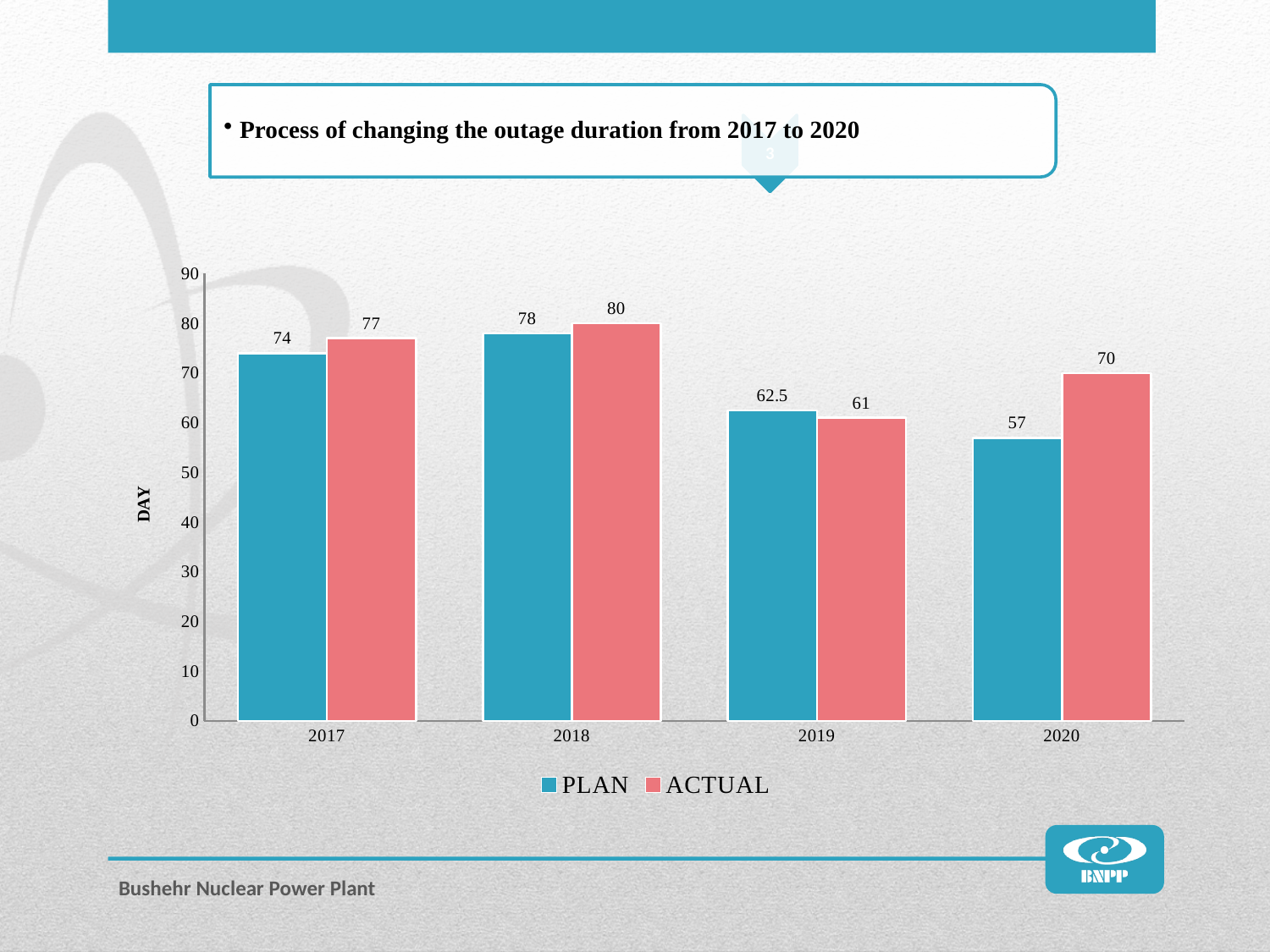
What is the label on the vertical axis? DAY What is the PLAN value for 2017? 74 What is the difference between the PLAN values for 2018 and 2019? 15.5 How many years are shown on the x axis? 4 What is the difference between the ACTUAL and PLAN values for 2020? 13 How many series does the legend list? 2 Which is larger for 2019, the PLAN value or the ACTUAL value? PLAN What is the PLAN value for 2019? 62.5 Which year has the highest ACTUAL value? 2018 Which year has the lowest PLAN value? 2020 What kind of chart is shown on the slide? Bar chart What is the ACTUAL value for 2020? 70